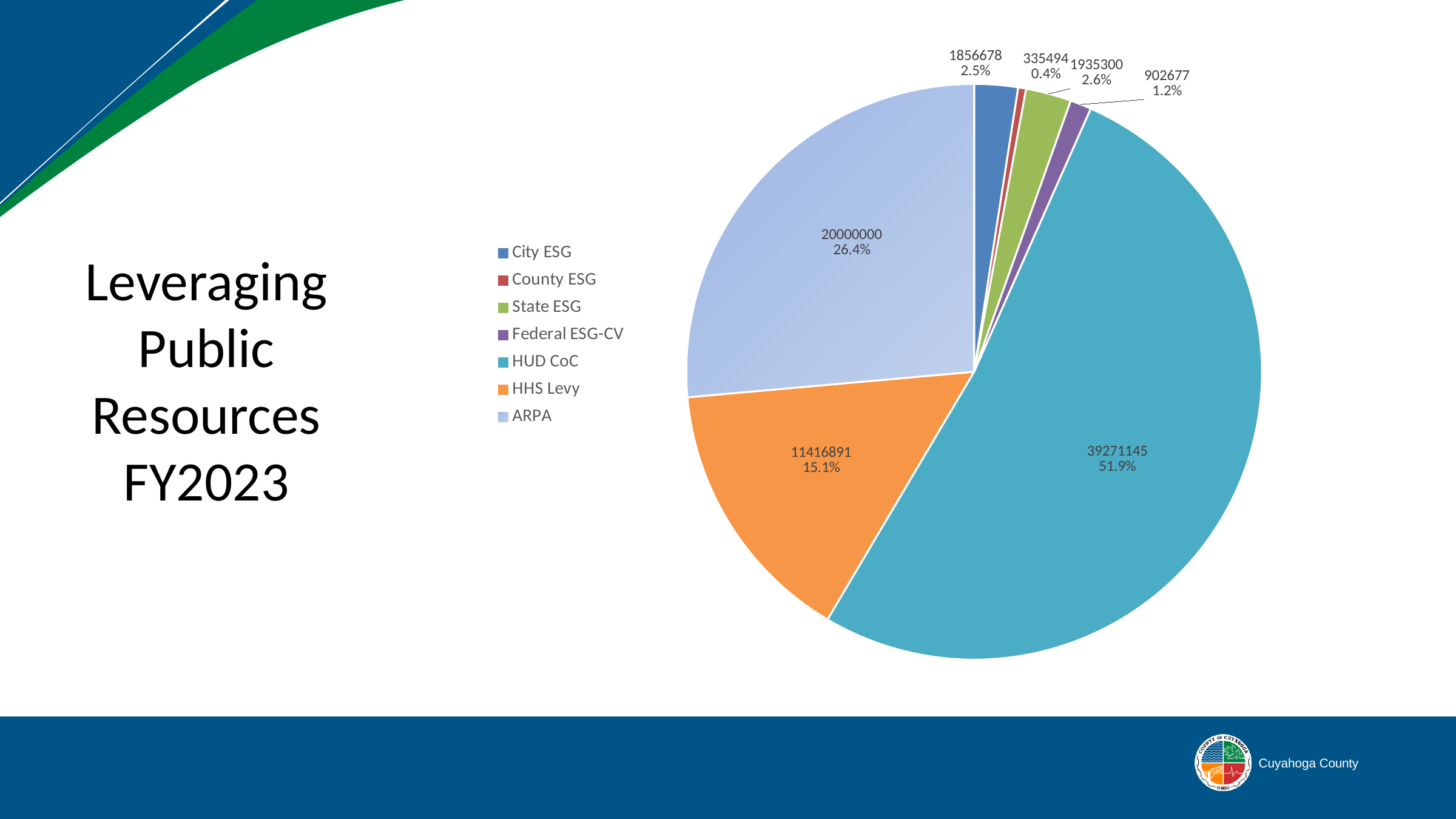
How many slices does the pie chart have? 7 Which category has the largest slice of the pie? HUD CoC What is the difference between the value for ARPA and the value for HHS Levy? 8583109 What is the value shown for Federal ESG-CV? 902677 What is the value shown for HUD CoC? 39271145 What percentage share does County ESG have? 0.4% What kind of chart is shown on the slide? pie chart Which is larger, the value for State ESG or the value for City ESG? State ESG What is the value shown for HHS Levy? 11416891 What is the title of the slide containing the pie chart? Leveraging Public Resources FY2023 Which category has the smallest slice of the pie? County ESG What percentage share does ARPA have in the pie chart? 26.4%